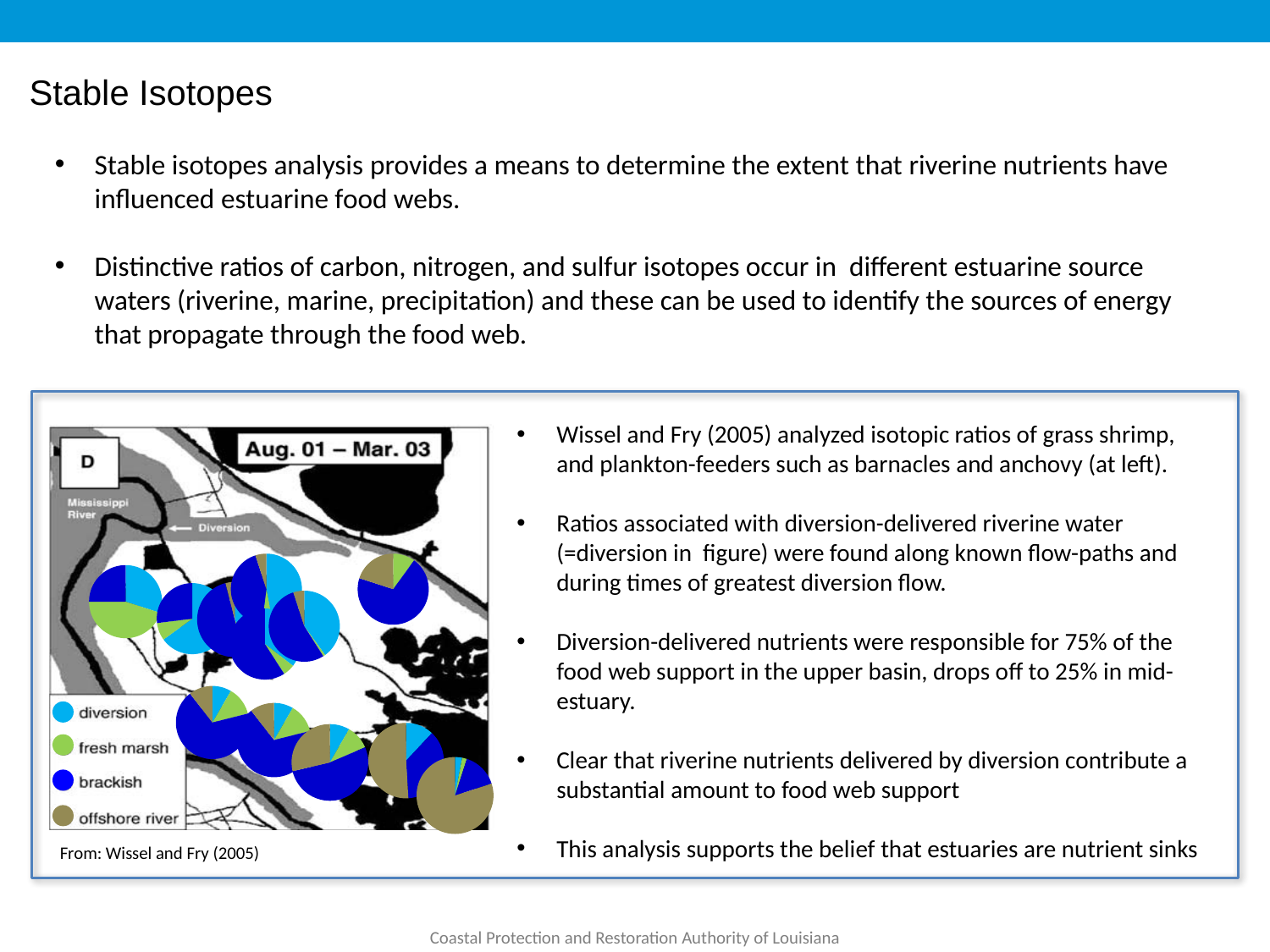
In the map figure, which category has the largest share in the large pie chart at the bottom left of the map (just right of the legend)? brackish In the map figure, which category has the largest share in the pie chart at the top right of the map? brackish What kind of chart is used on the map in the figure at the bottom left of the slide? pie chart Which legend entry in the map figure is shown in dark blue? brackish Which colour represents 'diversion' in the legend of the map figure? light blue How many categories does the legend of the map figure list? 4 What time period is shown in the label at the top of the map figure? Aug. 01 – Mar. 03 In the map figure, which category has the largest share in the pie chart at the far bottom right of the map? offshore river